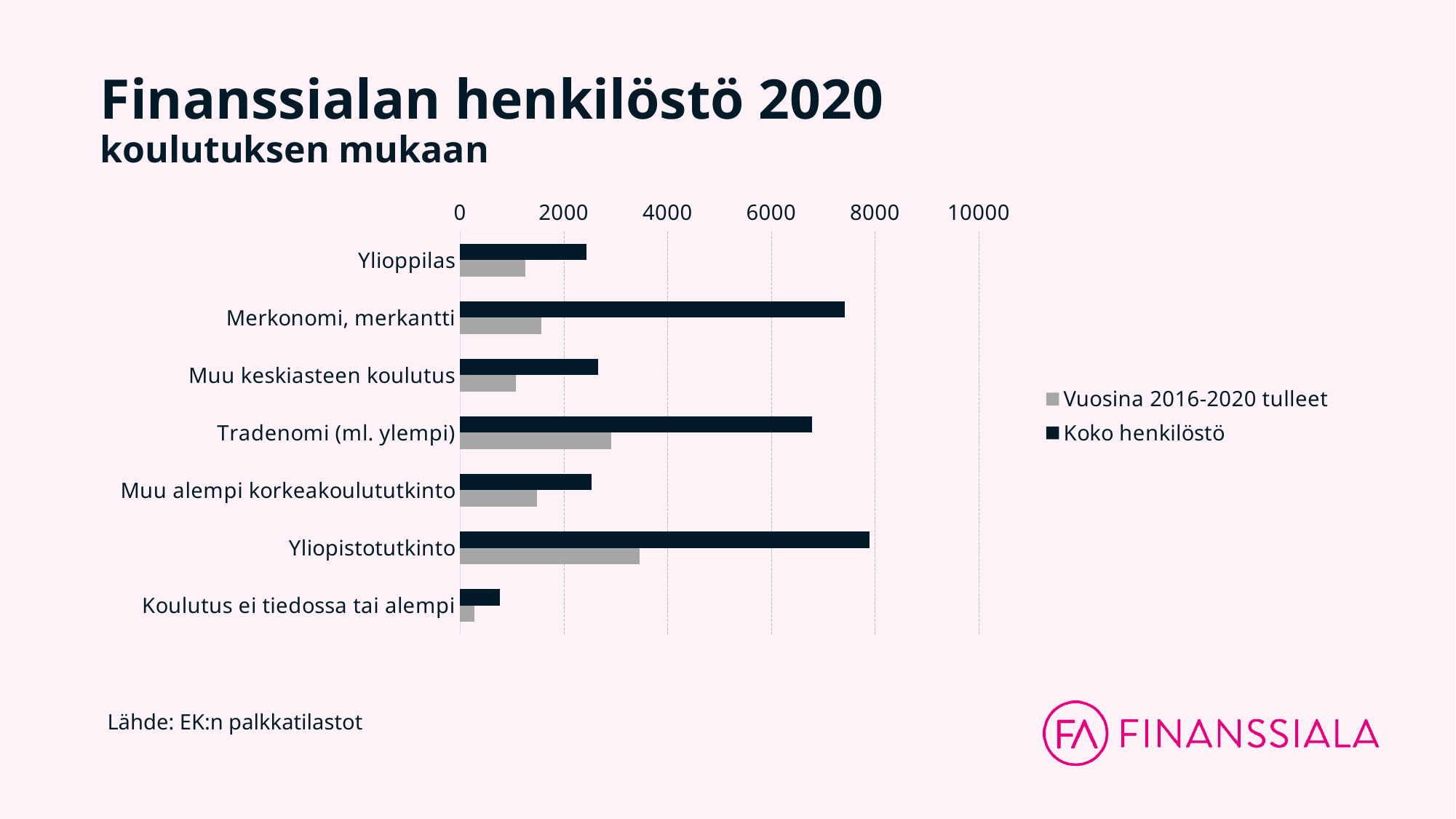
Is the Koko henkilöstö value for Ylioppilas greater or less than 2000? greater What is the title of the chart on the slide? Finanssialan henkilöstö 2020 koulutuksen mukaan Which category has the highest value for Koko henkilöstö? Yliopistotutkinto Is the Koko henkilöstö value for Merkonomi, merkantti greater or less than 6000? greater Is the Vuosina 2016-2020 tulleet value for Yliopistotutkinto greater or less than 4000? less Which category has the lowest value for Koko henkilöstö? Koulutus ei tiedossa tai alempi What kind of chart is shown on the slide? bar chart Which is larger for Koko henkilöstö: Merkonomi, merkantti or Tradenomi (ml. ylempi)? Merkonomi, merkantti How many series does the legend list? 2 How many education categories are shown on the chart? 7 Which category has the highest value for Vuosina 2016-2020 tulleet? Yliopistotutkinto